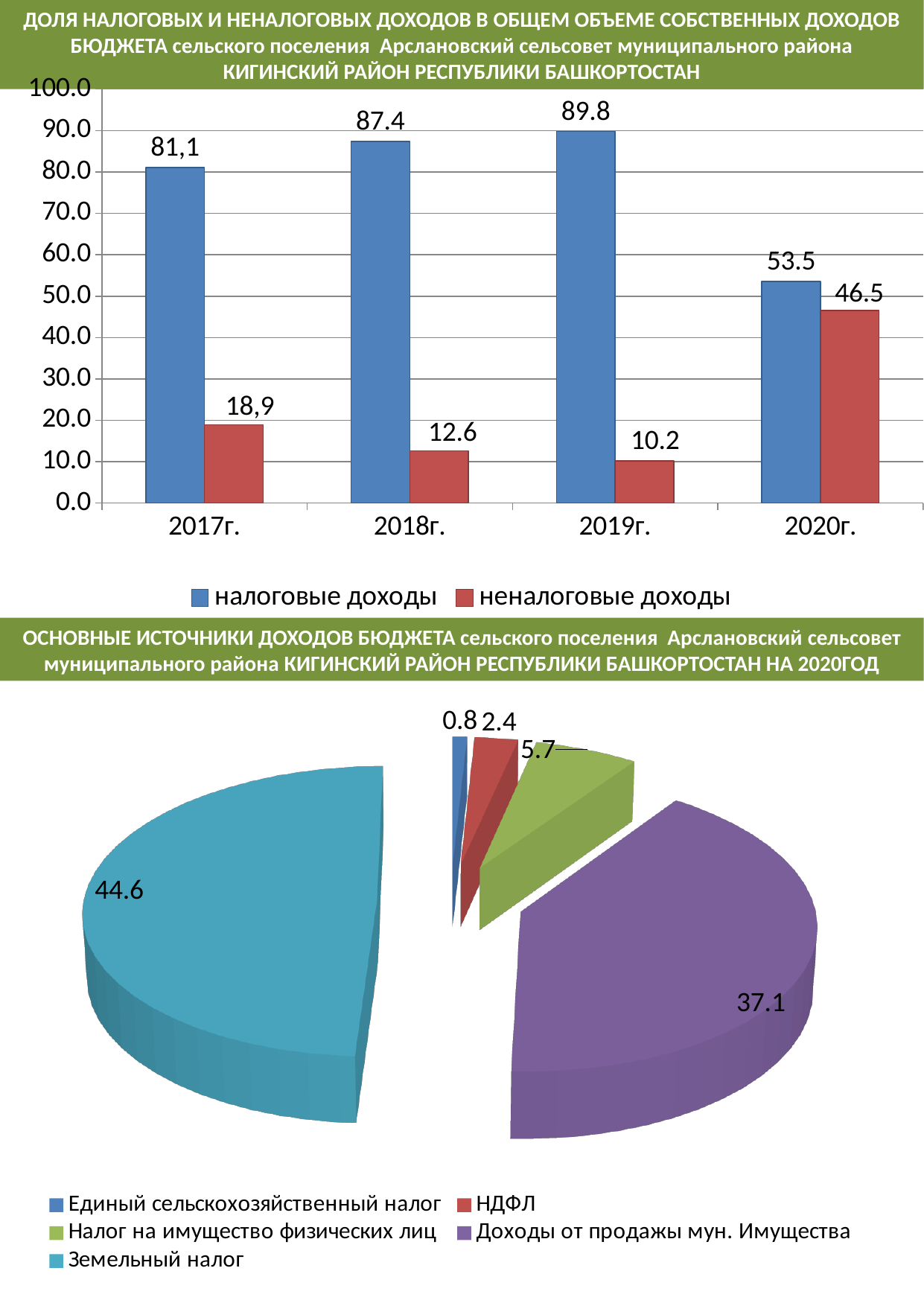
In the bottom pie chart, which is larger: Доходы от продажи мун. Имущества or Налог на имущество физических лиц? Доходы от продажы мун. Имущества In the top bar chart, what is the difference between налоговые доходы and неналоговые доходы in 2020г.? 7.0 In the top bar chart, what is the value of налоговые доходы for 2019г.? 89.8 In the top bar chart, which year has the highest value for налоговые доходы? 2019г. In the top bar chart, what is the value of неналоговые доходы for 2017г.? 18,9 What kind of chart is the top chart on the slide? Bar chart In the top bar chart, how does the value of налоговые доходы change from 2019г. to 2020г.? It falls In the bottom pie chart, how many categories does the legend list? 5 In the bottom pie chart, which category has the smallest slice? Единый сельскохозяйственный налог In the bottom pie chart, what is the value for Земельный налог? 44.6 In the top bar chart, how many series does the legend list? 2 In the top bar chart, which year has the lowest value for неналоговые доходы? 2019г.